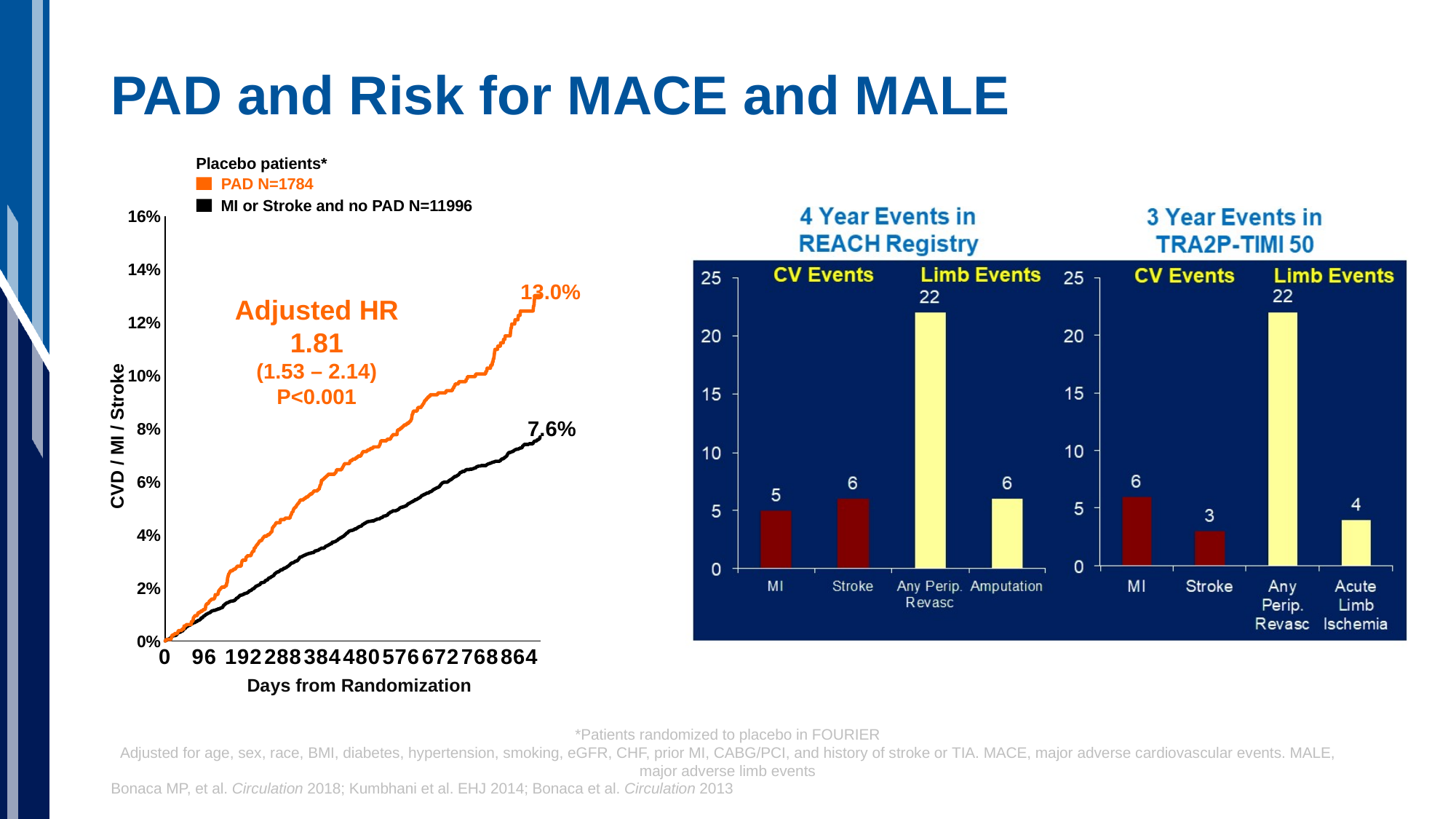
In the left line chart, do the curves rise or fall as days from randomization increase? rise In the left line chart, what is the final event rate labelled for the MI or Stroke and no PAD group? 7.6% In the left line chart, what is the final event rate labelled for the PAD group? 13.0% In the left line chart, what is the difference between the final PAD rate and the final MI or Stroke and no PAD rate? 5.4% In the 4 Year Events in REACH Registry chart, what is the difference between Stroke and MI? 1 In the left line chart, what is the adjusted HR shown? 1.81 In the 3 Year Events in TRA2P-TIMI 50 chart, which is larger, MI or Stroke? MI In the 3 Year Events in TRA2P-TIMI 50 chart, what is the value for Acute Limb Ischemia? 4 In the 4 Year Events in REACH Registry chart, what is the value for Any Perip. Revasc? 22 In the 4 Year Events in REACH Registry chart, which category has the lowest value? MI In the left line chart, how many series does the legend list? 2 What kind of chart is the 3 Year Events in TRA2P-TIMI 50 chart? bar chart